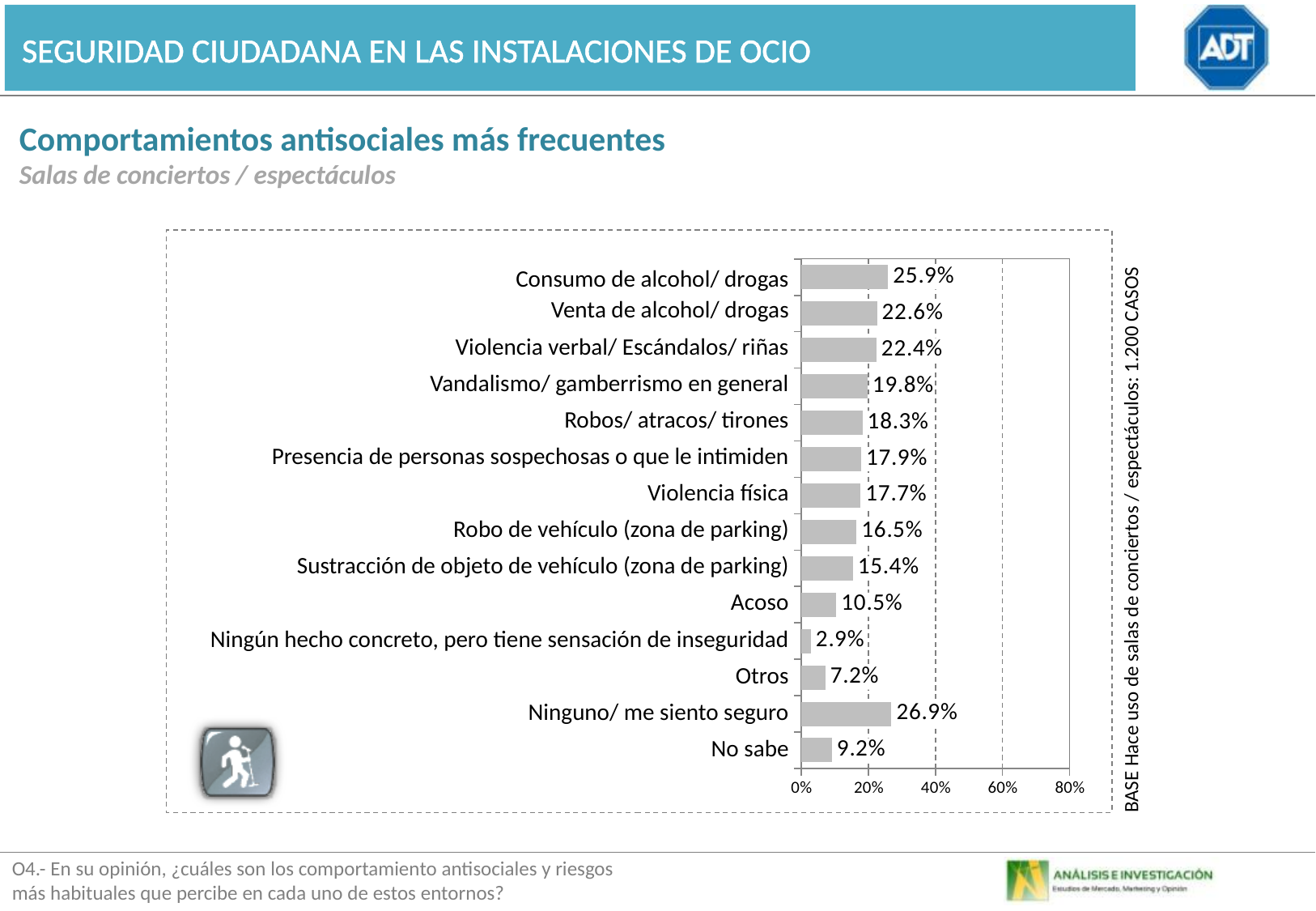
What is the value for Acoso? 10.5% What is the difference between Consumo de alcohol/ drogas and Venta de alcohol/ drogas? 3.3% How many categories are shown in the chart? 14 What kind of chart is shown? bar chart Which is larger, Robos/ atracos/ tirones or Violencia física? Robos/ atracos/ tirones Which category has the highest value? Ninguno/ me siento seguro What is the base stated next to the chart? 1.200 CASOS Is the value for Ninguno/ me siento seguro greater or less than 40%? less What is the value for Otros? 7.2% What is the value for Consumo de alcohol/ drogas? 25.9% Which category has the lowest value? Ningún hecho concreto, pero tiene sensación de inseguridad What is the value for No sabe? 9.2%